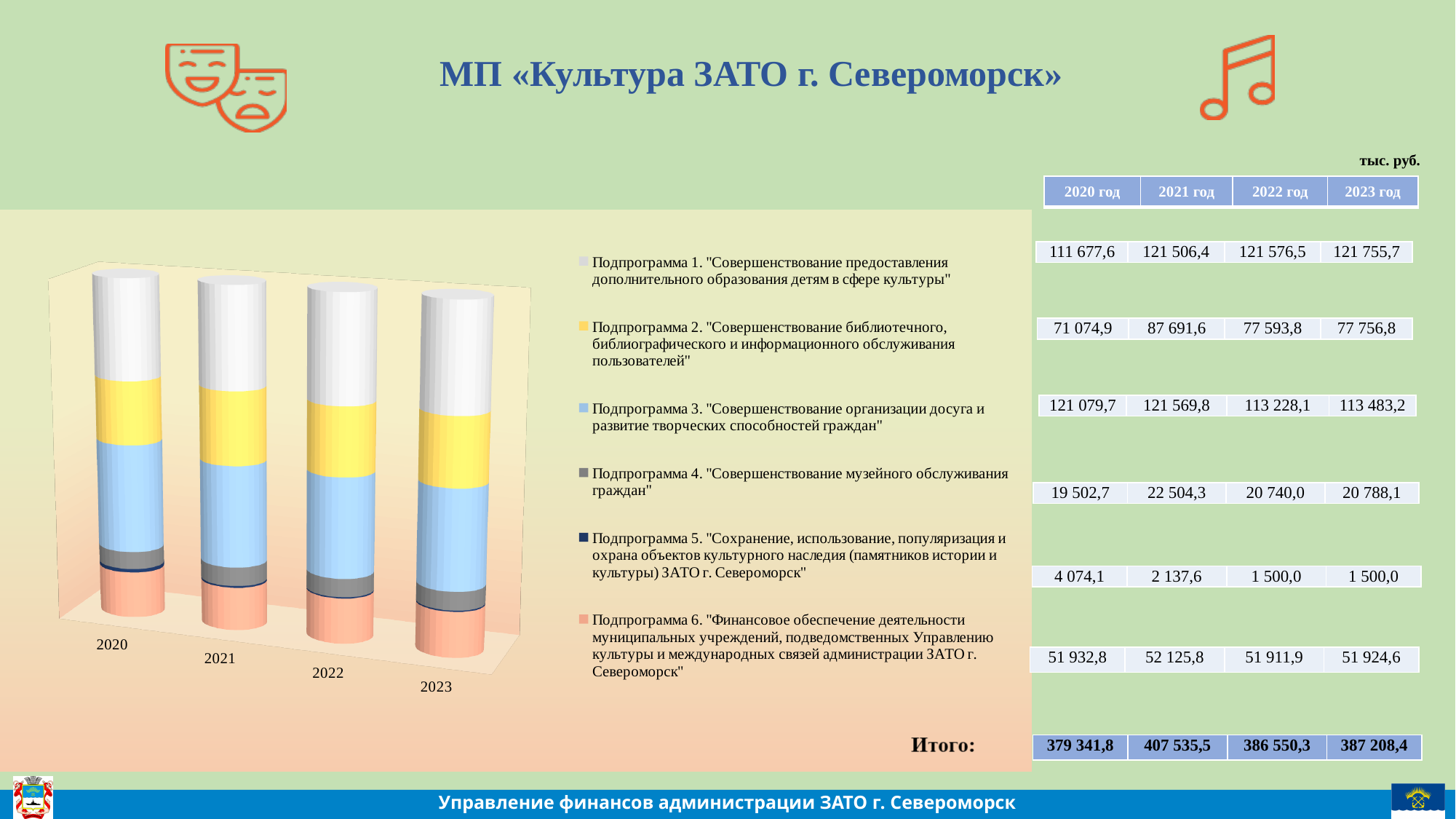
What is the value for Подпрограмма 4 in 2021 год? 22 504,3 How many series (subprograms) does the chart legend list? 6 Which year has the highest total (Итого)? 2021 год How many years (categories) are plotted along the x axis of the chart? 4 Which year has the lowest total (Итого)? 2020 год In 2020 год, which is larger: the value for Подпрограмма 3 or for Подпрограмма 1? Подпрограмма 3 What kind of chart is shown on the slide? stacked bar chart What is the value for Подпрограмма 5 in 2022 год? 1 500,0 Does the value for Подпрограмма 5 rise or fall from 2020 год to 2023 год? fall What is the difference between the values for Подпрограмма 2 in 2021 год and 2020 год? 16 616,7 What is the value for Подпрограмма 1 in 2020 год? 111 677,6 What is the total (Итого) of the stacked bar for 2023 год? 387 208,4